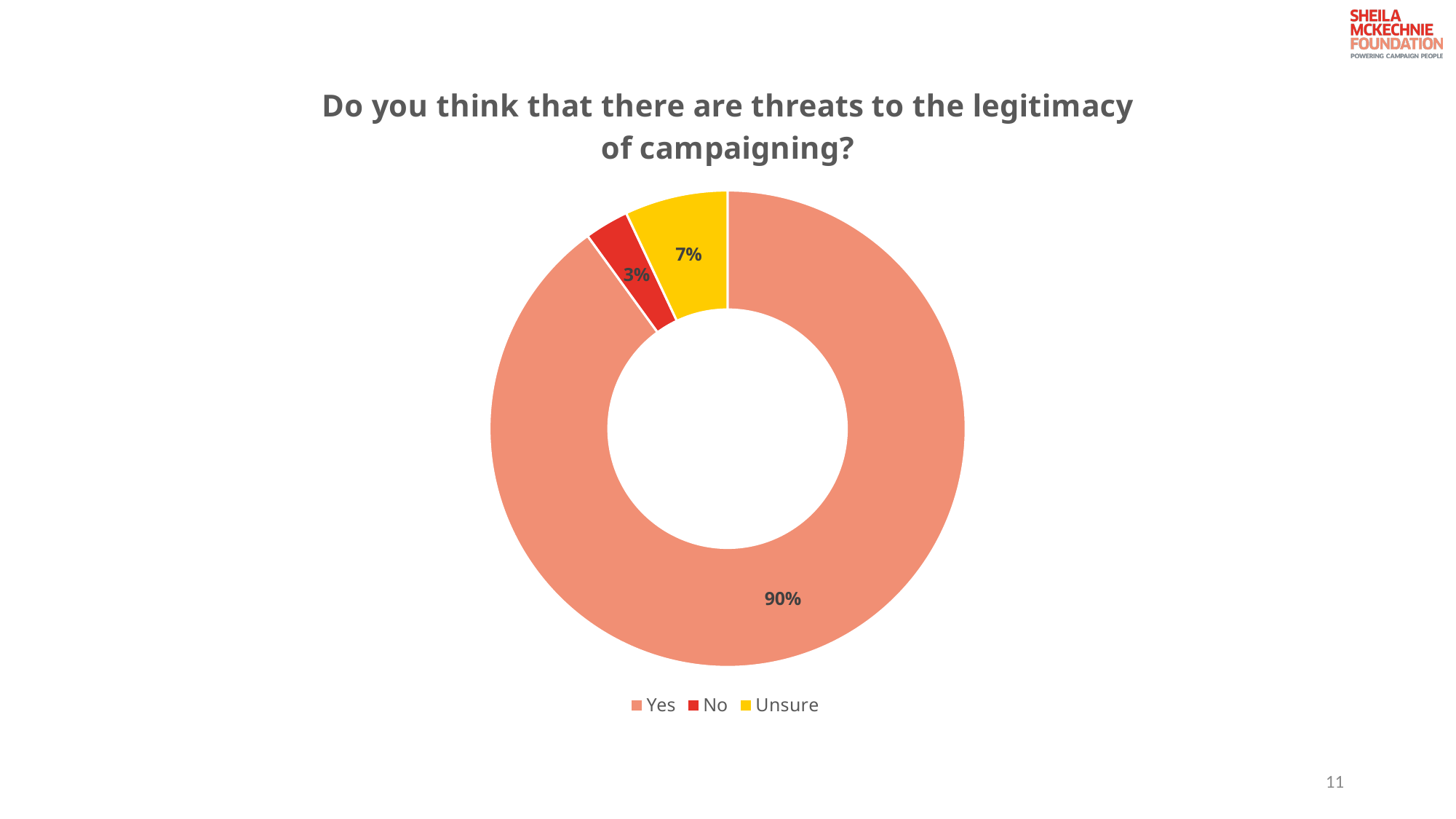
What percentage of respondents answered "No"? 3% What percentage of respondents answered "Yes"? 90% What percentage of respondents answered "Unsure"? 7% How many response categories are shown in the chart? 3 Which is larger, the share for "Unsure" or the share for "No"? Unsure What kind of chart is shown on the slide? Doughnut (pie) chart Which response has the smallest share of the chart? No What is the difference in percentage points between the "Yes" and "Unsure" shares? 83 What is the title of the chart? Do you think that there are threats to the legitimacy of campaigning? What is the difference in percentage points between the "Unsure" and "No" shares? 4 What colour represents the "Unsure" category in the chart? Yellow Which response has the largest share of the chart? Yes